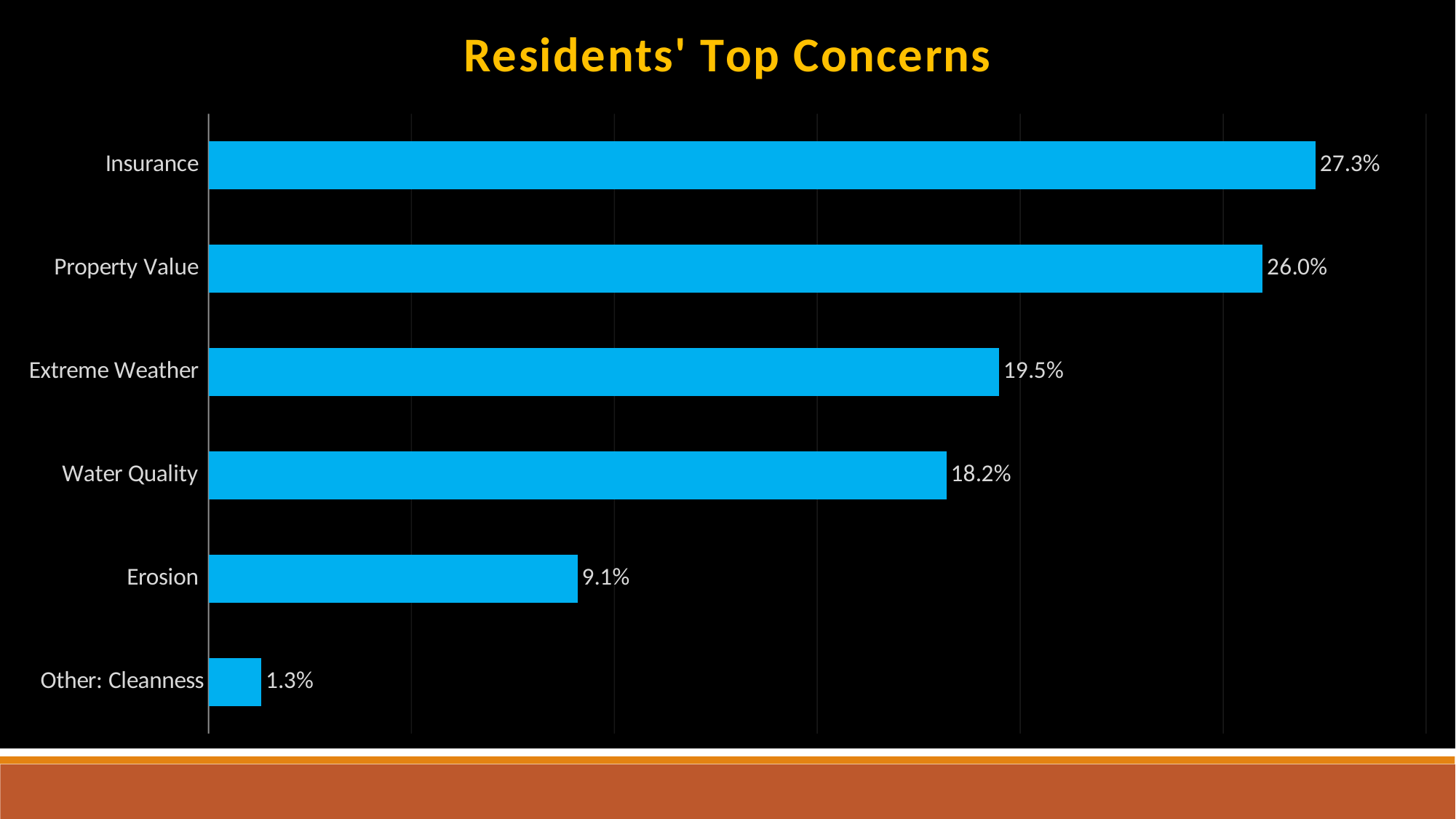
How many categories are shown in the chart? 6 Which is larger, the value for Water Quality or the value for Erosion? Water Quality What is the difference between the values for Extreme Weather and Water Quality? 1.3% What is the title of the chart? Residents' Top Concerns What is the value for Extreme Weather? 19.5% What kind of chart is shown on the slide? Bar chart What is the value for Other: Cleanness? 1.3% What is the value for Erosion? 9.1% Which category has the highest value? Insurance Which category has the lowest value? Other: Cleanness What is the difference between the values for Insurance and Property Value? 1.3% What is the value for Insurance? 27.3%